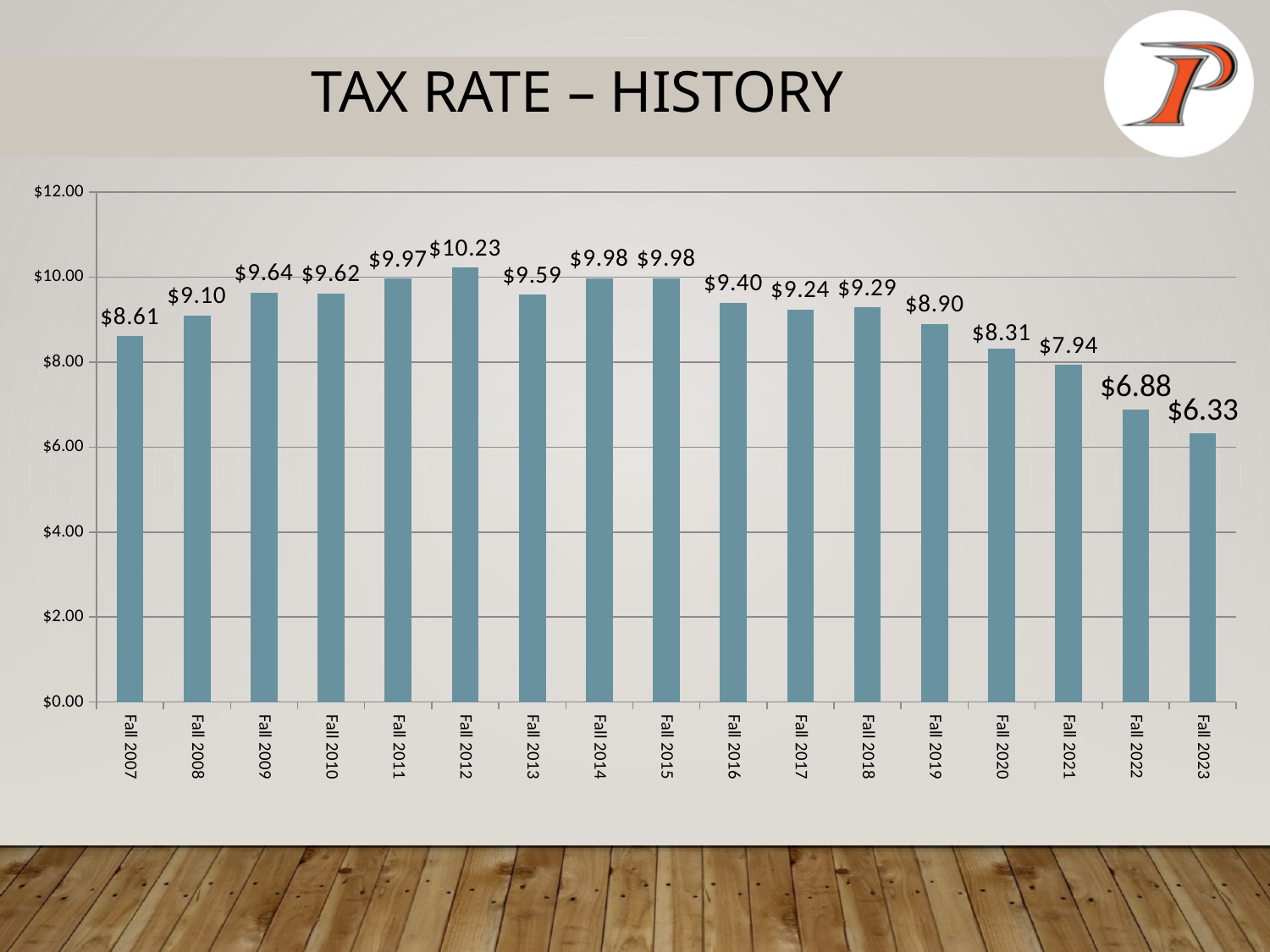
Is the tax rate for Fall 2021 greater or less than $8.00? less Which is larger, the tax rate for Fall 2009 or Fall 2019? Fall 2009 How many years are shown on the chart? 17 What is the difference between the tax rate in Fall 2012 and Fall 2023? $3.90 Does the tax rate rise or fall from Fall 2015 to Fall 2023? fall Which year has the highest tax rate? Fall 2012 What is the tax rate for Fall 2023? $6.33 What is the tax rate for Fall 2012? $10.23 What is the title of the slide? TAX RATE – HISTORY What is the tax rate for Fall 2007? $8.61 What kind of chart is shown on the slide? bar chart Which year has the lowest tax rate? Fall 2023